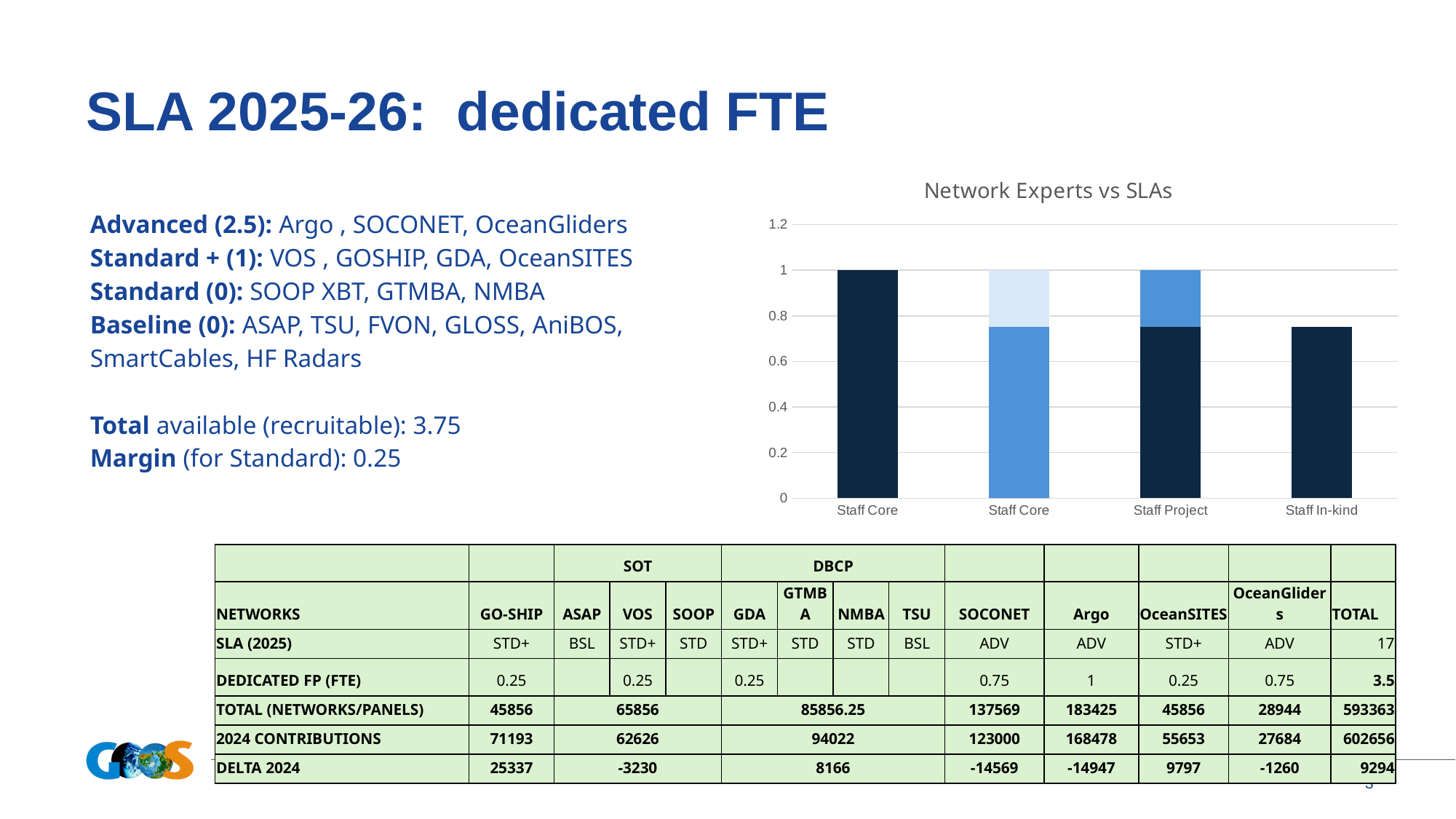
In the Network Experts vs SLAs chart, which is larger: the first Staff Core bar or the Staff In-kind bar? Staff Core In the Network Experts vs SLAs chart, is the dark segment of the Staff Project bar greater or less than 0.6? greater What is the highest value shown on the vertical axis of the Network Experts vs SLAs chart? 1.2 In the Network Experts vs SLAs chart, is the value for Staff In-kind greater or less than 0.8? less In the Network Experts vs SLAs chart, is the value for Staff In-kind greater or less than 0.6? greater Which category has the lowest bar in the Network Experts vs SLAs chart? Staff In-kind What kind of chart is shown on the slide? bar chart In the Network Experts vs SLAs chart, what value does the first Staff Core bar reach? 1 How many bars are plotted in the Network Experts vs SLAs chart? 4 What is the title of the chart on the slide? Network Experts vs SLAs In the Network Experts vs SLAs chart, what is the total height of the stacked Staff Project bar? 1